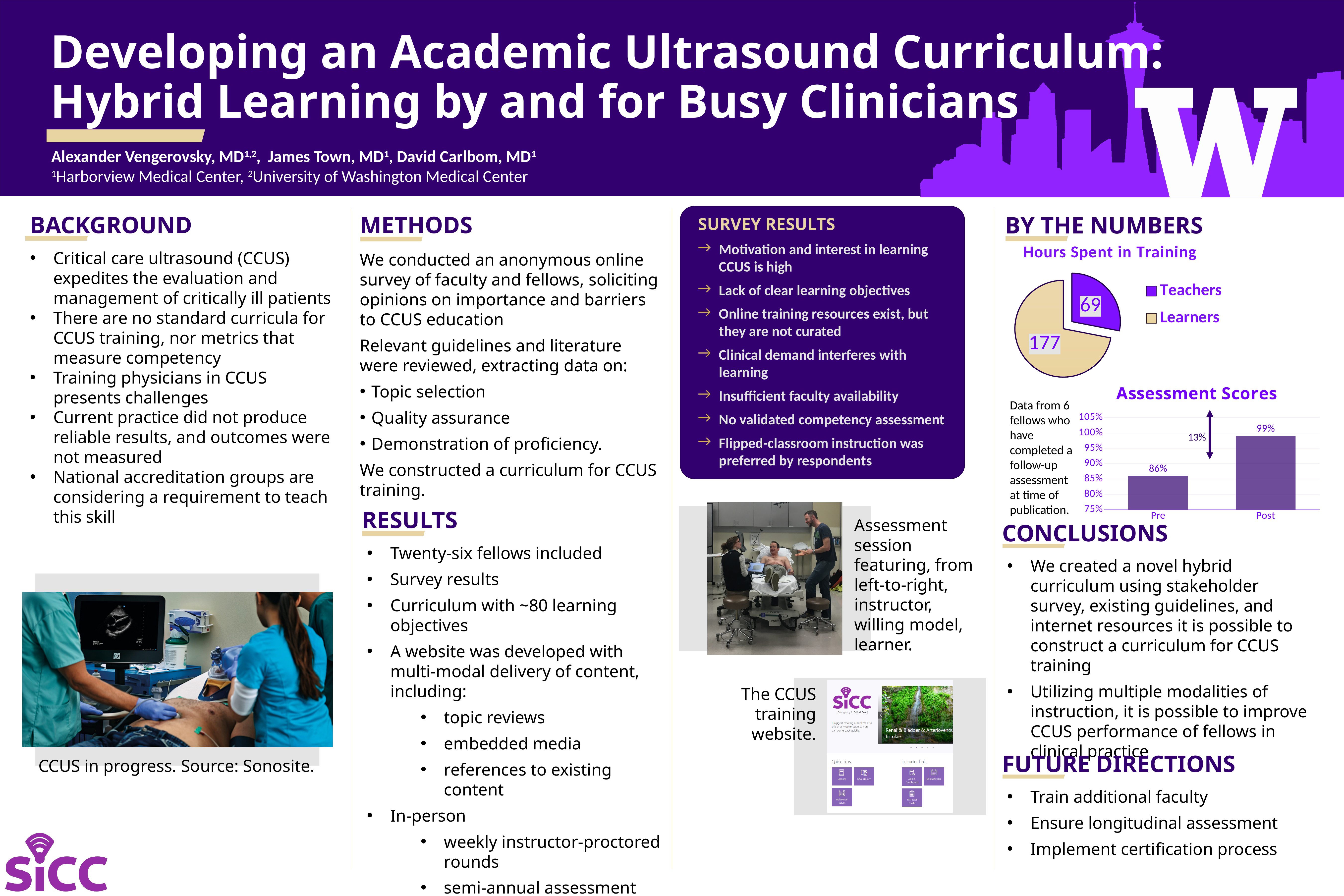
In the "Assessment Scores" chart, do the scores rise or fall from Pre to Post? rise In the "Hours Spent in Training" chart, what value is shown for Learners? 177 In the "Hours Spent in Training" chart, what value is shown for Teachers? 69 In the "Hours Spent in Training" chart, which group has the larger slice? Learners How many categories does the legend of the "Hours Spent in Training" chart list? 2 What kind of chart is "Assessment Scores"? bar chart In the "Hours Spent in Training" chart, what is the difference between the Learners and Teachers values? 108 In the "Assessment Scores" chart, what is the Pre score? 86% In the "Assessment Scores" chart, is the Pre value greater or less than 90%? less What kind of chart is "Hours Spent in Training"? pie chart In the "Assessment Scores" chart, what is the difference between the Post and Pre scores? 13% In the "Assessment Scores" chart, what is the Post score? 99%